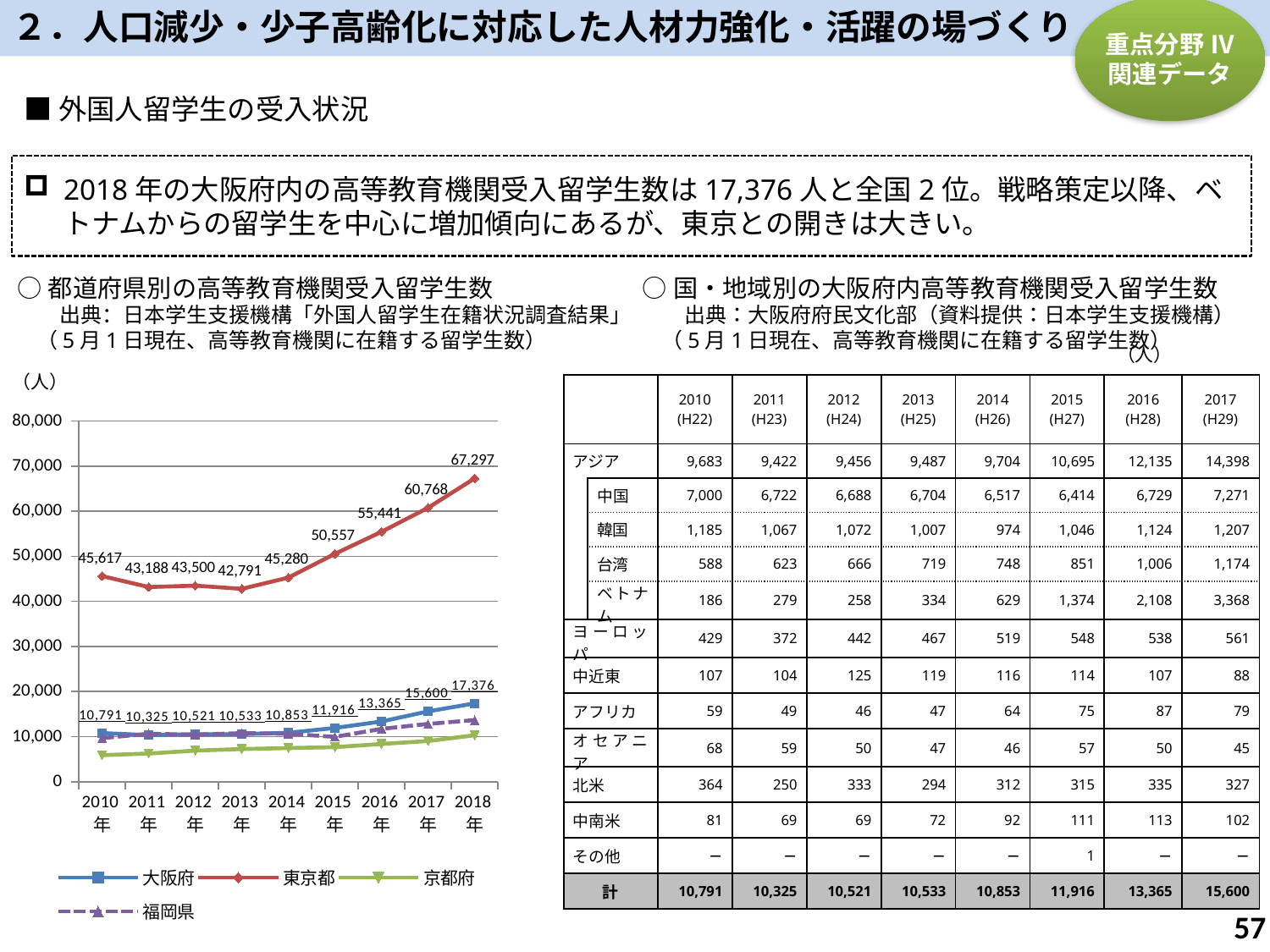
In the line chart, what is the value for 東京都 in 2018年? 67,297 How many years are plotted along the x axis of the line chart? 9 In the line chart, which prefecture has the highest value in 2018年? 東京都 What kind of chart is shown on the left of the slide? Line chart In the line chart, what is the value for 東京都 in 2013年? 42,791 In the line chart, does the value for 東京都 rise or fall from 2014年 to 2018年? rise How many series does the legend of the line chart list? 4 In the line chart, which prefecture has the lowest value in 2010年? 京都府 In the line chart, what is the difference between 東京都 and 大阪府 in 2018年? 49,921 In the line chart, what is the value for 大阪府 in 2010年? 10,791 In the line chart, is the value for 京都府 in 2018年 greater or less than 20,000? less In the line chart, what is the value for 大阪府 in 2018年? 17,376